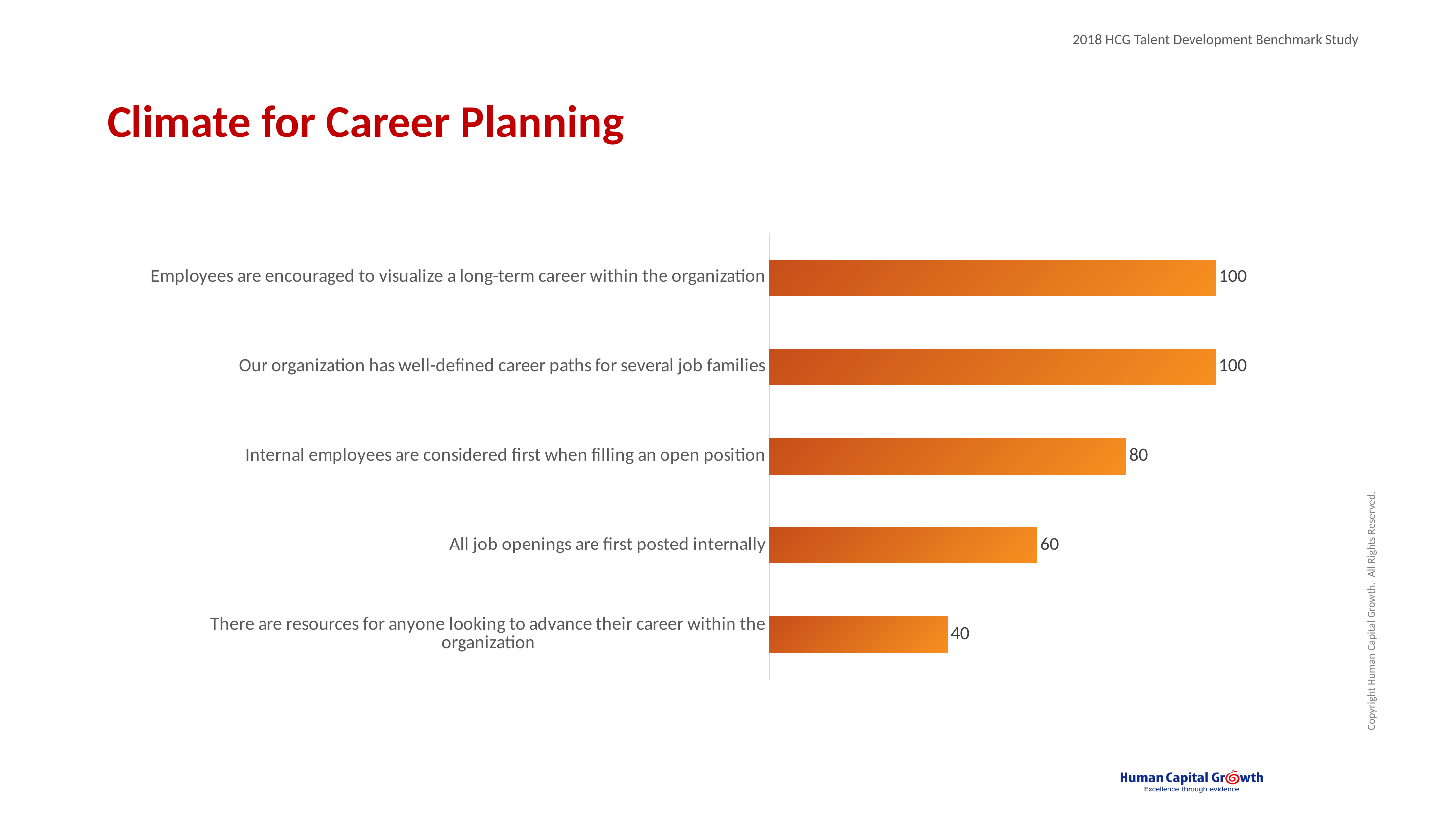
What is the difference between the values for "Internal employees are considered first when filling an open position" and "All job openings are first posted internally"? 20 What is the value for "All job openings are first posted internally"? 60 Which category has the lowest value? There are resources for anyone looking to advance their career within the organization What is the difference between the values for "Employees are encouraged to visualize a long-term career within the organization" and "There are resources for anyone looking to advance their career within the organization"? 60 What is the value for "Our organization has well-defined career paths for several job families"? 100 What is the value for "Internal employees are considered first when filling an open position"? 80 How many categories are shown in the chart? 5 What kind of chart is shown on the slide? Bar chart Which is larger: the value for "All job openings are first posted internally" or the value for "There are resources for anyone looking to advance their career within the organization"? All job openings are first posted internally How many categories have a value of 100? 2 What is the value for "There are resources for anyone looking to advance their career within the organization"? 40 What is the title of the slide containing the chart? Climate for Career Planning